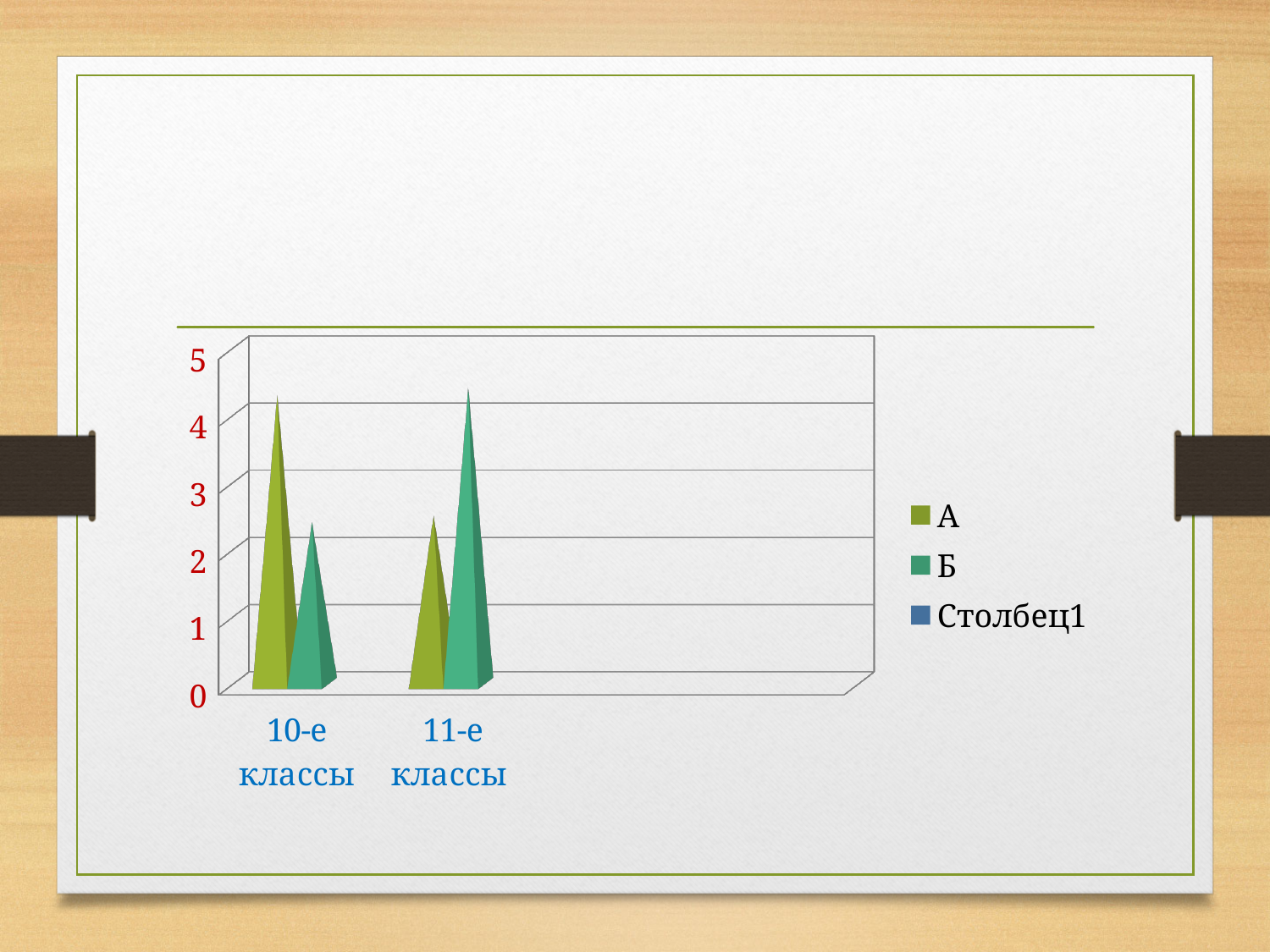
Is the value for series Б in 11-е классы greater or less than 3? greater In 11-е классы, which series has the larger value, А or Б? Б What are the names of the series listed in the legend? А, Б, Столбец1 How many series does the chart's legend list? 3 What kind of chart is shown on the slide? bar chart Is the value for series А in 11-е классы greater or less than 3? less How many categories are shown on the x axis of the chart? 2 For series Б, which category has the lowest value? 10-е классы In 10-е классы, which series has the larger value, А or Б? А For series А, which category has the highest value? 10-е классы Is the value for series А in 10-е классы greater or less than 3? greater